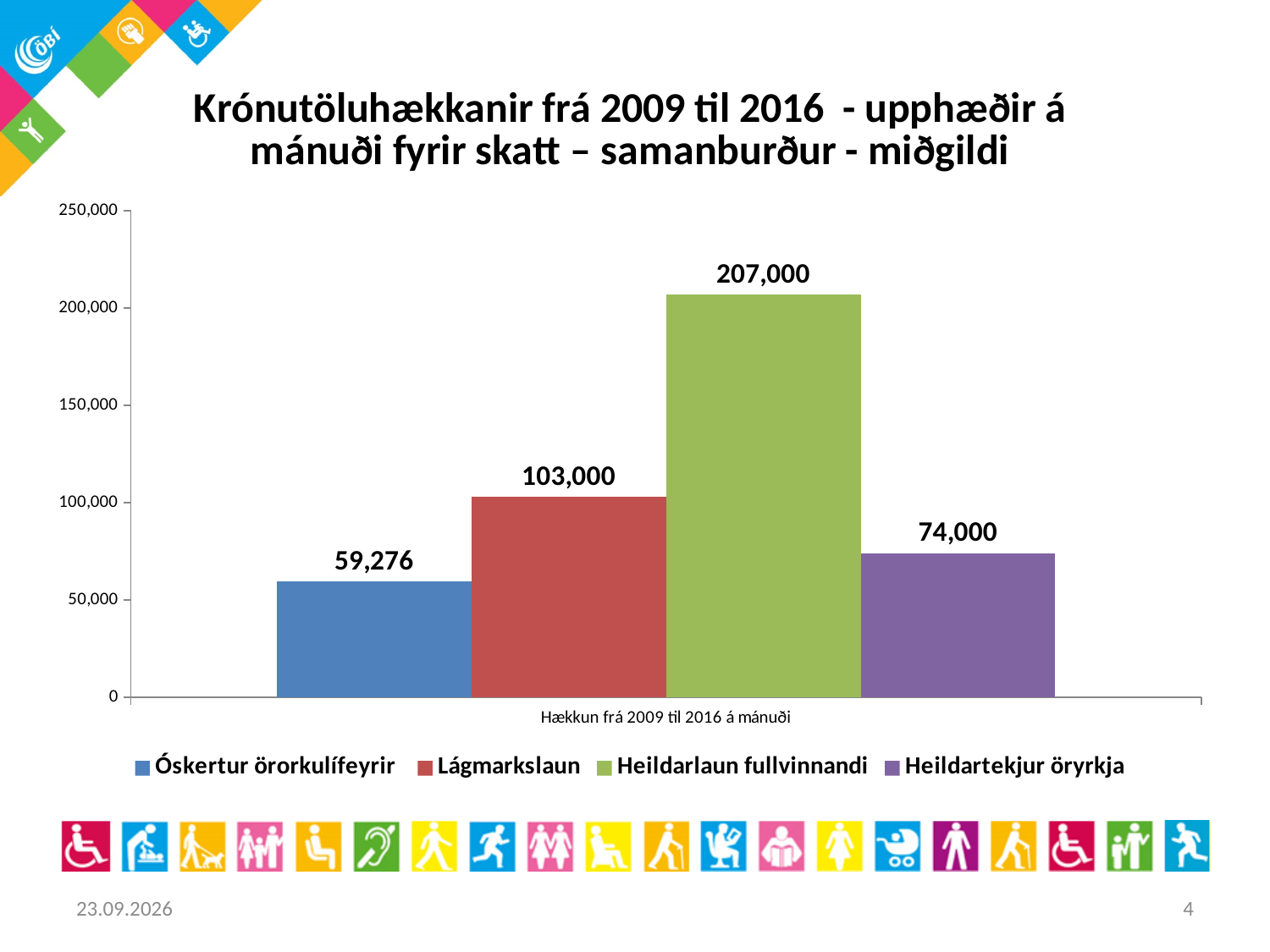
What is the value for Óskertur örorkulífeyrir? 59,276 Which is larger, Lágmarkslaun or Heildartekjur öryrkja? Lágmarkslaun What is the label on the x axis of the chart? Hækkun frá 2009 til 2016 á mánuði Which series has the highest value? Heildarlaun fullvinnandi What is the value for Heildarlaun fullvinnandi? 207,000 Which series has the lowest value? Óskertur örorkulífeyrir What is the value for Heildartekjur öryrkja? 74,000 How many series does the legend list? 4 What is the difference between Heildarlaun fullvinnandi and Lágmarkslaun? 104,000 What is the difference between Heildartekjur öryrkja and Óskertur örorkulífeyrir? 14,724 What kind of chart is shown on the slide? Bar chart What is the value for Lágmarkslaun? 103,000